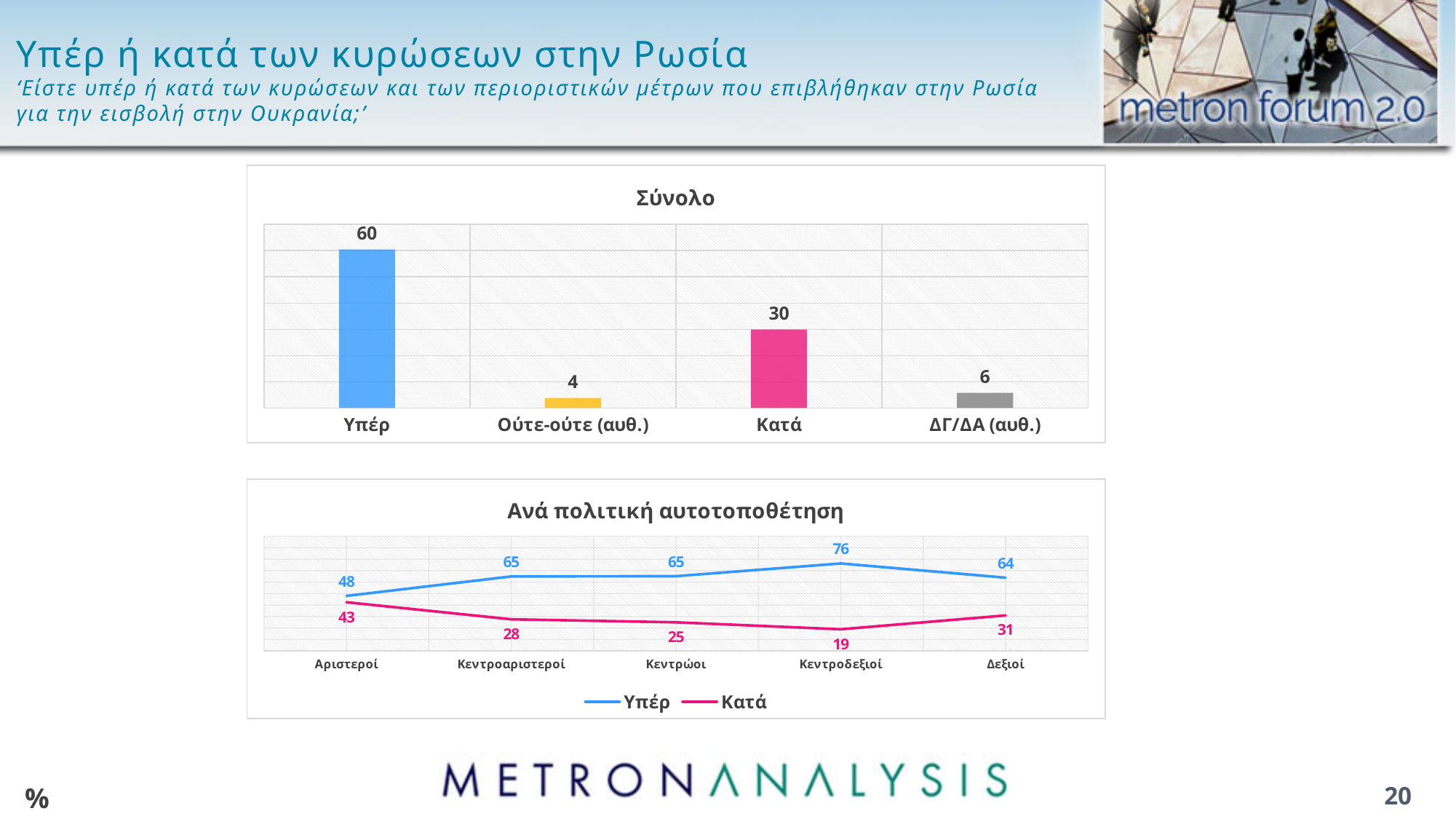
In the 'Ανά πολιτική αυτοτοποθέτηση' chart, which category has the lowest 'Κατά' value? Κεντροδεξιοί What kind of chart is the 'Ανά πολιτική αυτοτοποθέτηση' chart? line chart In the 'Ανά πολιτική αυτοτοποθέτηση' chart, what is the 'Κατά' value for 'Αριστεροί'? 43 In the 'Ανά πολιτική αυτοτοποθέτηση' chart, how many series does the legend list? 2 In the 'Σύνολο' chart, what is the value for 'Υπέρ'? 60 In the 'Ανά πολιτική αυτοτοποθέτηση' chart, what is the 'Υπέρ' value for 'Κεντροδεξιοί'? 76 In the 'Σύνολο' chart, what is the value for 'Κατά'? 30 In the 'Σύνολο' chart, how many categories are shown? 4 In the 'Σύνολο' chart, which category has the lowest value? Ούτε-ούτε (αυθ.) What kind of chart is the 'Σύνολο' chart? bar chart In the 'Σύνολο' chart, what is the difference between 'Υπέρ' and 'Κατά'? 30 In the 'Ανά πολιτική αυτοτοποθέτηση' chart, what is the difference between the 'Υπέρ' and 'Κατά' values for 'Δεξιοί'? 33